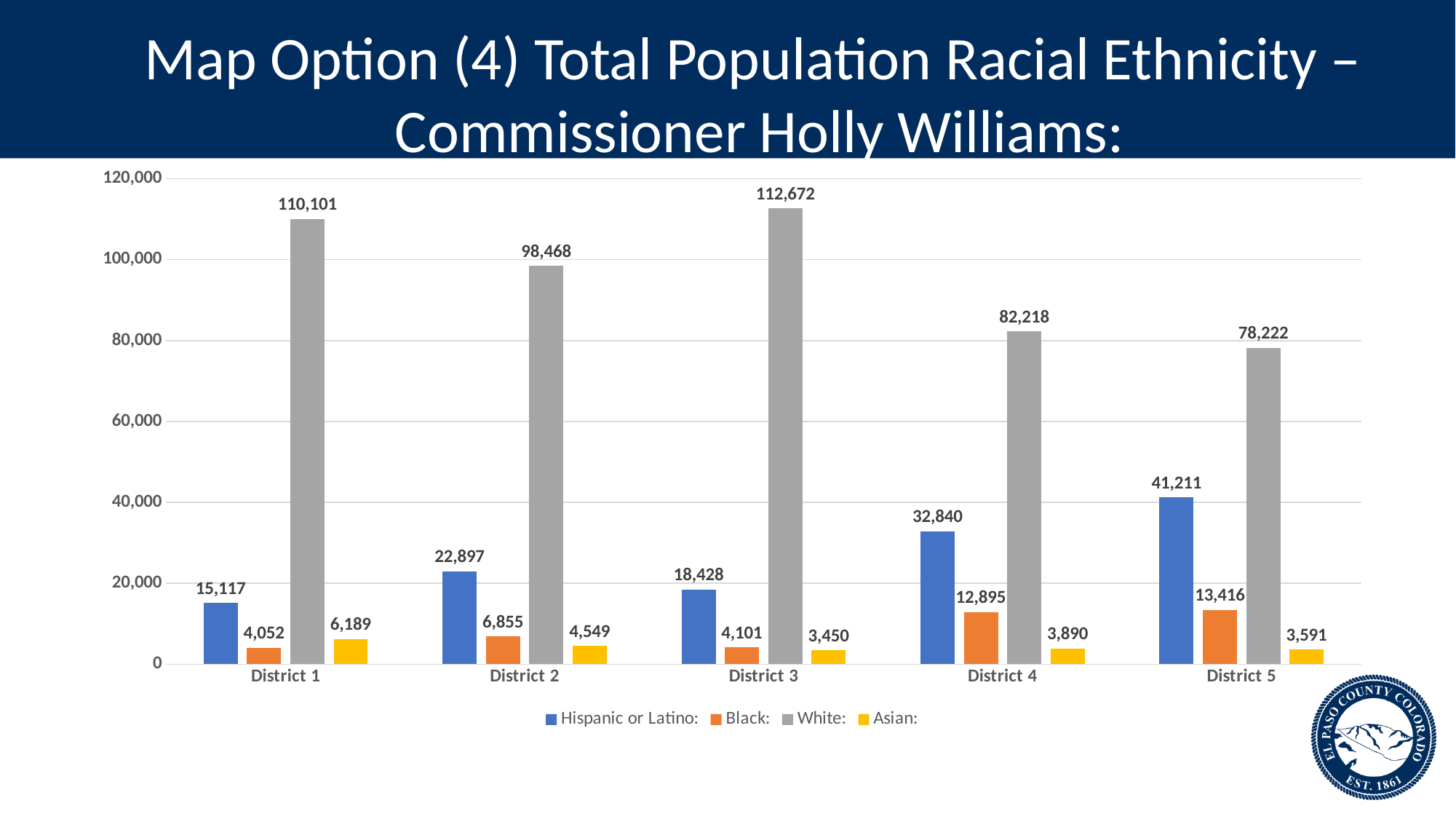
What is the difference between the White population in District 1 and District 2? 11,633 Which district has the lowest Hispanic or Latino population? District 1 How many districts are shown on the x axis? 5 What is the Asian population value for District 1? 6,189 How many series does the legend list? 4 What is the White population value for District 3? 112,672 Which district has the highest White population? District 3 Which colour represents the Asian series in the legend? Yellow Which is larger, the Black population in District 2 or in District 3? District 2 What is the Black population value for District 4? 12,895 What kind of chart is shown on the slide? Bar chart What is the Hispanic or Latino population value for District 5? 41,211